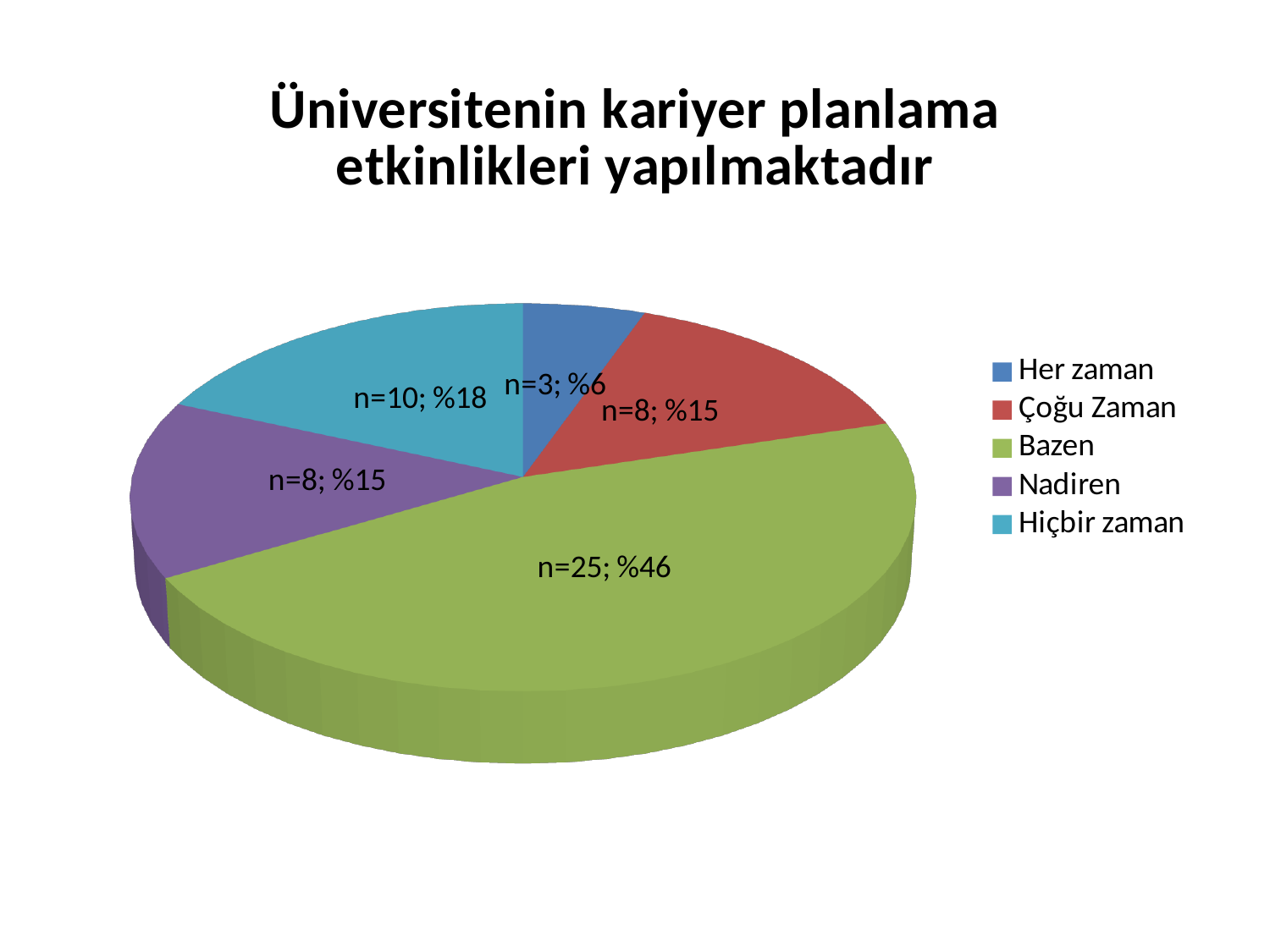
Which colour represents Nadiren in the chart? Purple What percentage share does the Çoğu Zaman slice have? %15 What is the title of the chart? Üniversitenin kariyer planlama etkinlikleri yapılmaktadır What is the data label for the Bazen slice? n=25; %46 What is the data label for the Her zaman slice? n=3; %6 What kind of chart is shown on the slide? Pie chart What is the data label for the Hiçbir zaman slice? n=10; %18 What is the difference in n between Bazen and Hiçbir zaman? 15 Which category has the smallest slice? Her zaman How many categories does the legend list? 5 Which category has the largest slice? Bazen Which is larger, the Hiçbir zaman slice or the Nadiren slice? Hiçbir zaman